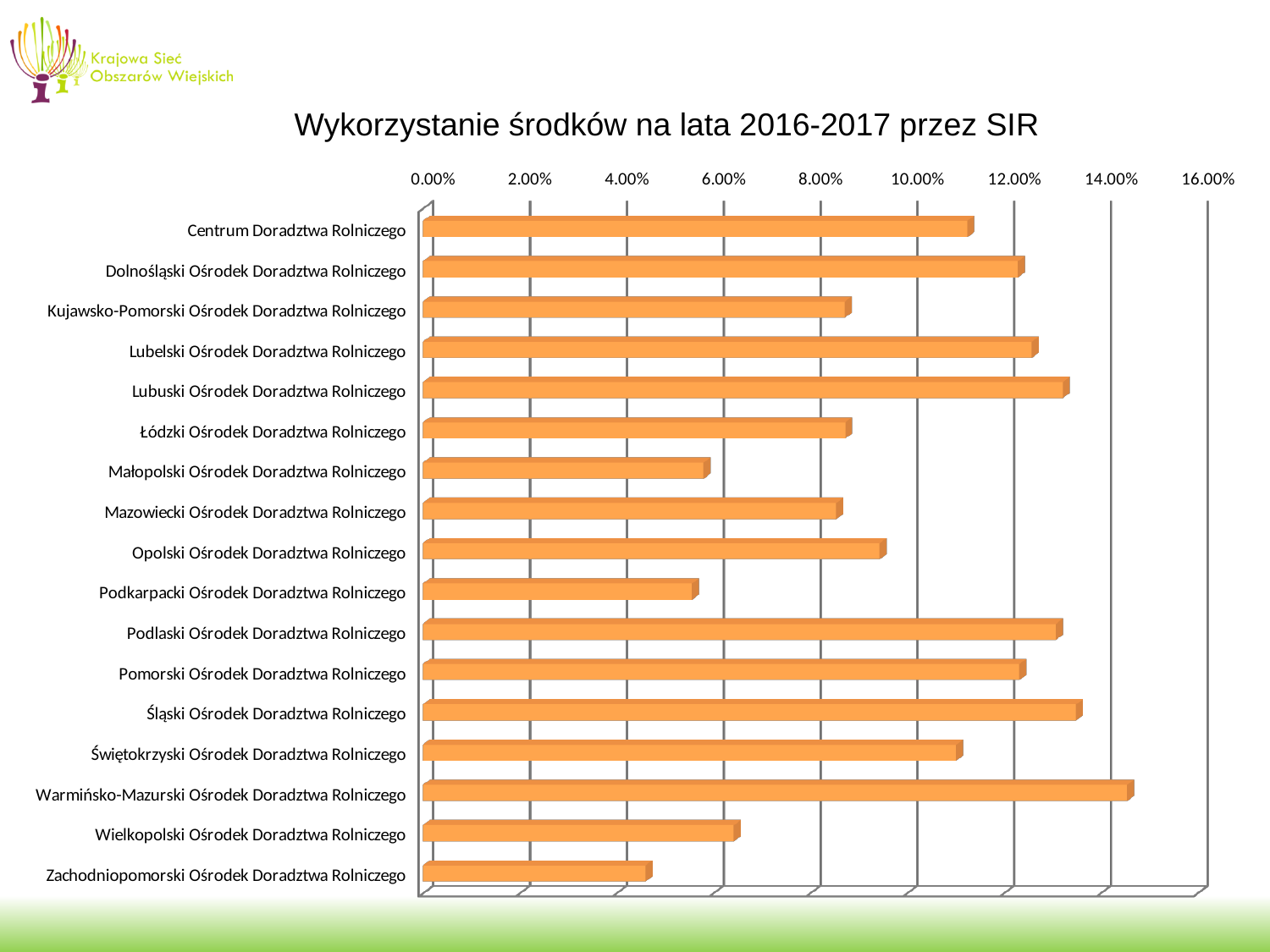
Is the value for Lubuski Ośrodek Doradztwa Rolniczego greater or less than 12.00%? greater Which institution has the highest value in the chart? Warmińsko-Mazurski Ośrodek Doradztwa Rolniczego How many categories (institutions) are plotted in the chart? 17 Which has the larger value: Warmińsko-Mazurski Ośrodek Doradztwa Rolniczego or Śląski Ośrodek Doradztwa Rolniczego? Warmińsko-Mazurski Ośrodek Doradztwa Rolniczego Is the value for Centrum Doradztwa Rolniczego greater or less than 10.00%? greater Is the value for Warmińsko-Mazurski Ośrodek Doradztwa Rolniczego greater or less than 14.00%? greater Which has the larger value: Opolski Ośrodek Doradztwa Rolniczego or Mazowiecki Ośrodek Doradztwa Rolniczego? Opolski Ośrodek Doradztwa Rolniczego What is the title of the chart? Wykorzystanie środków na lata 2016-2017 przez SIR Which institution has the lowest value in the chart? Zachodniopomorski Ośrodek Doradztwa Rolniczego What kind of chart is shown on the slide? bar chart